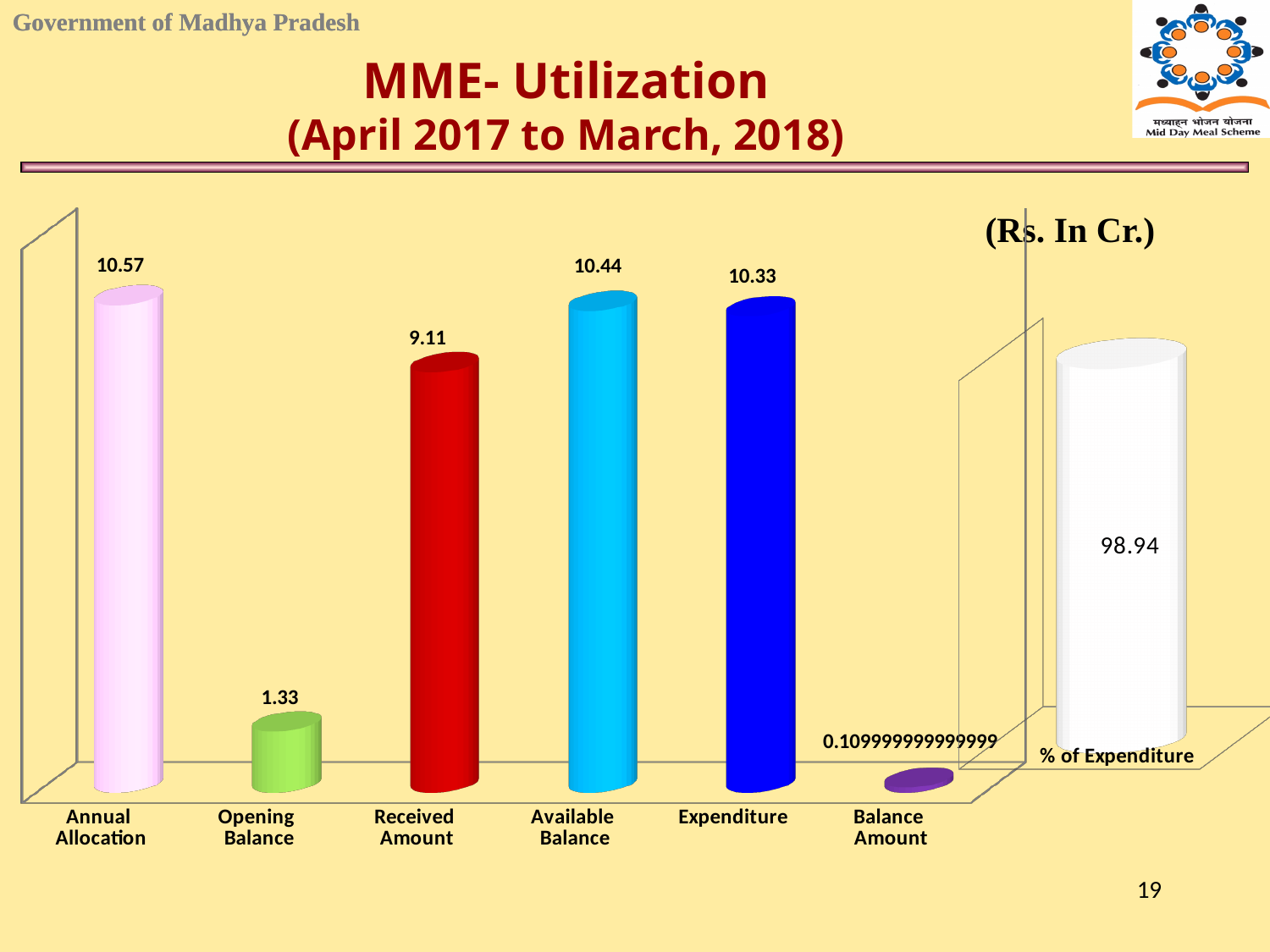
Which category has the lowest value on the chart? Balance Amount Which is larger, Available Balance or Expenditure? Available Balance What is the difference between Annual Allocation and Received Amount? 1.46 What is the value for Received Amount? 9.11 What value is shown for % of Expenditure? 98.94 What kind of chart is shown on the slide? Bar chart What is the value for Expenditure? 10.33 What is the value for Available Balance? 10.44 What is the value for Opening Balance? 1.33 In what unit are the values on the chart expressed, according to the label on the slide? Rs. In Cr. Among the Rs. In Cr. categories (excluding % of Expenditure), which has the highest value? Annual Allocation What is the value for Annual Allocation? 10.57